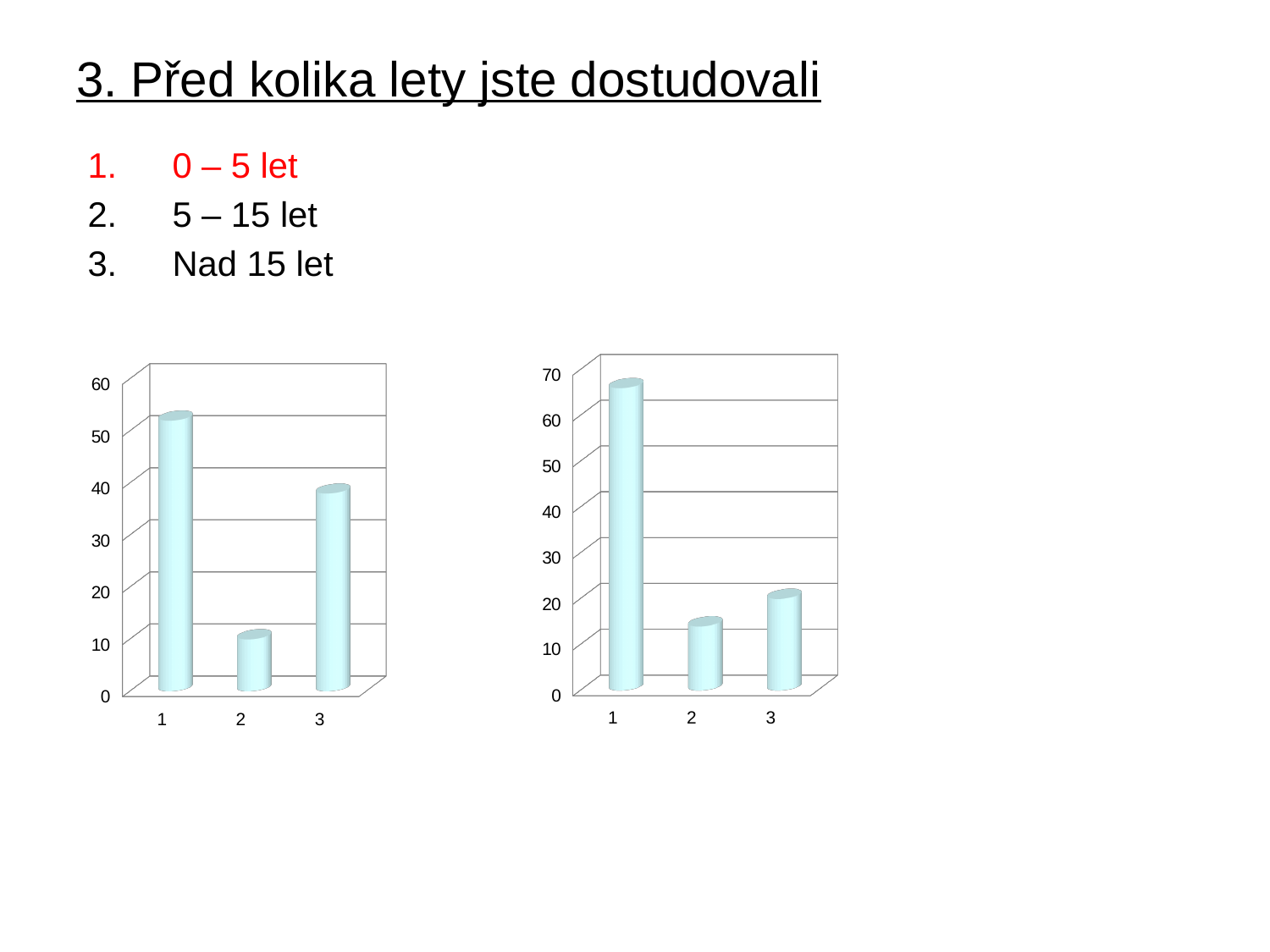
In the right chart, which category has the lowest bar? 2 What is the highest value shown on the vertical axis of the right chart? 70 In the right chart, which category has the highest bar? 1 In the right chart, is the value for category 2 greater or less than 20? less In the right chart, is the value for category 1 greater or less than 60? greater In the left chart, is the value for category 1 greater or less than 40? greater In the left chart, which category has the lowest bar? 2 In the left chart, which category has the highest bar? 1 How many categories are shown on the x axis of the left chart? 3 What kind of chart is the left chart on the slide? bar chart In the left chart, which is larger, the value for category 3 or the value for category 2? category 3